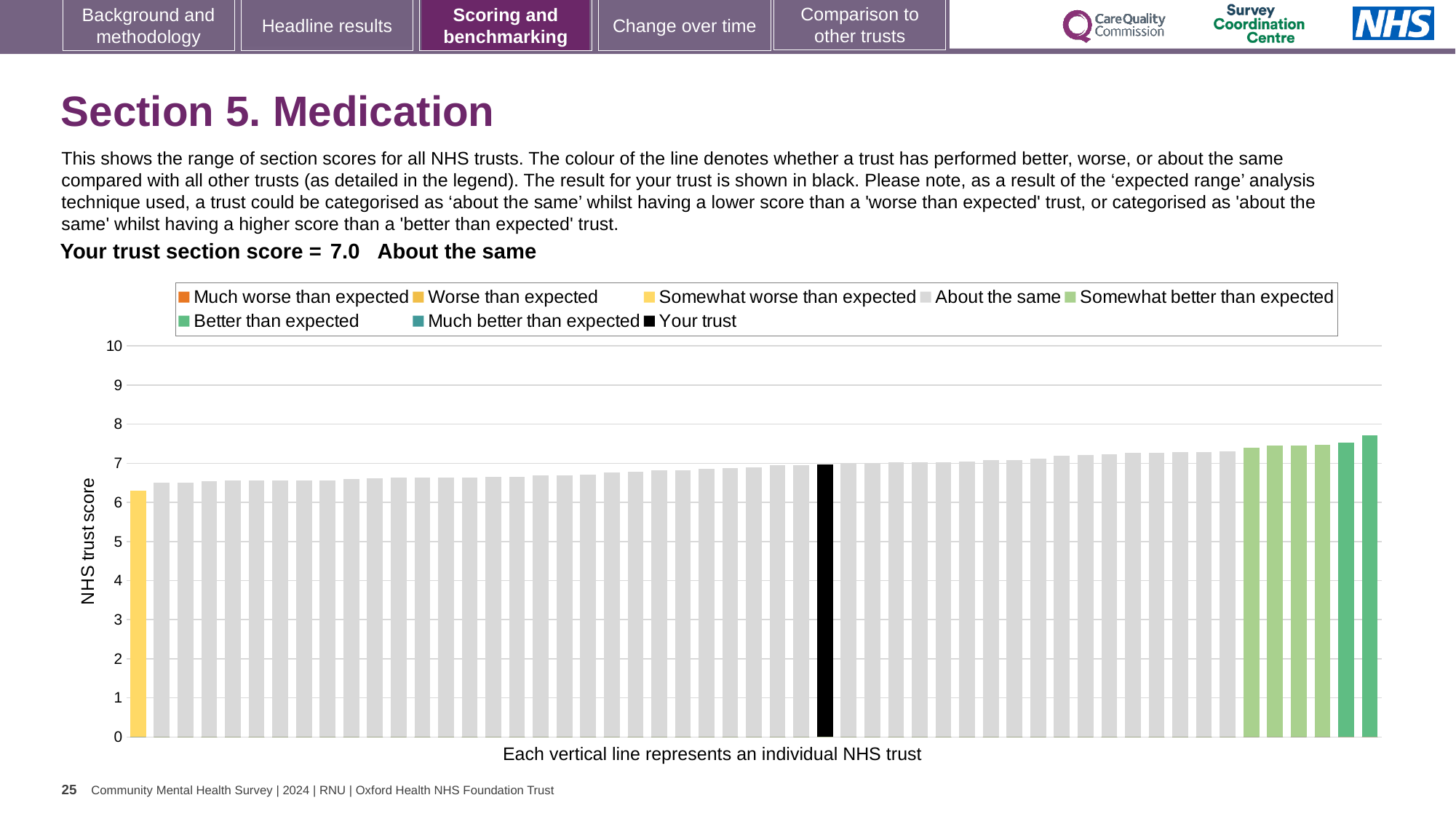
What is the trust section score printed on the slide? 7.0 What colour is the bar representing your trust? black Is the value of the leftmost (yellow) bar greater or less than 5? greater What category is the trust's section score placed in, according to the text above the chart? About the same Is the value of the tallest bar greater or less than 7? greater Do the bar values rise or fall from left to right along the x axis? rise How many entries does the chart legend list? 8 Is the value of the tallest bar greater or less than 8? less What kind of chart is shown on the slide? bar chart What is the label of the vertical axis? NHS trust score